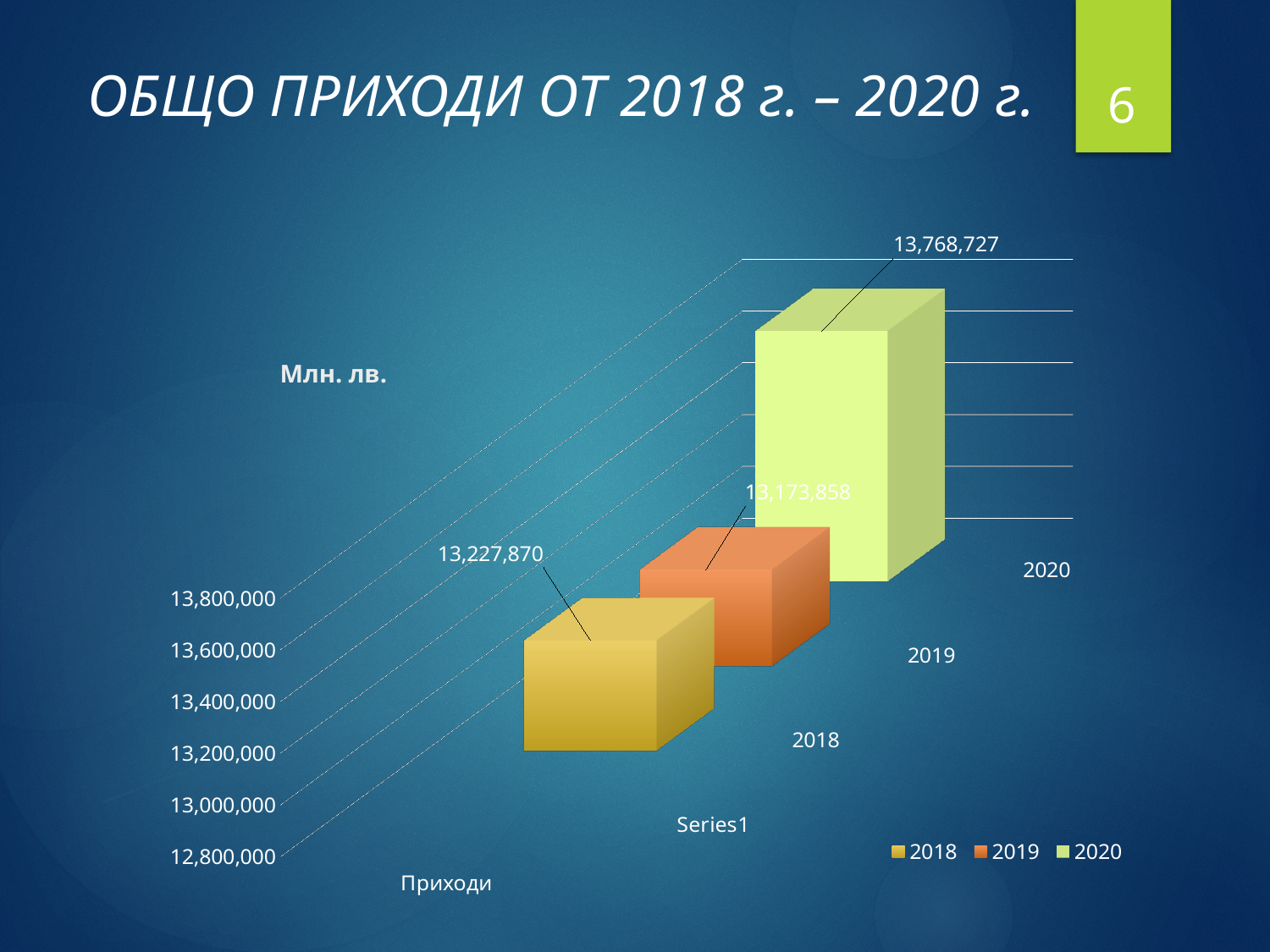
Which is larger, the value for 2018 or the value for 2019? 2018 What is the value for 2020? 13,768,727 What is the difference between the values for 2020 and 2018? 540,857 Which year has the lowest value? 2019 Is the value for 2020 greater or less than 13,600,000? greater How many series does the legend list? 3 What is the value for 2018? 13,227,870 What is the title of the slide? ОБЩО ПРИХОДИ ОТ 2018 г. – 2020 г. What is the value for 2019? 13,173,858 Which year has the highest value? 2020 What is the difference between the values for 2018 and 2019? 54,012 What kind of chart is shown on the slide? bar chart